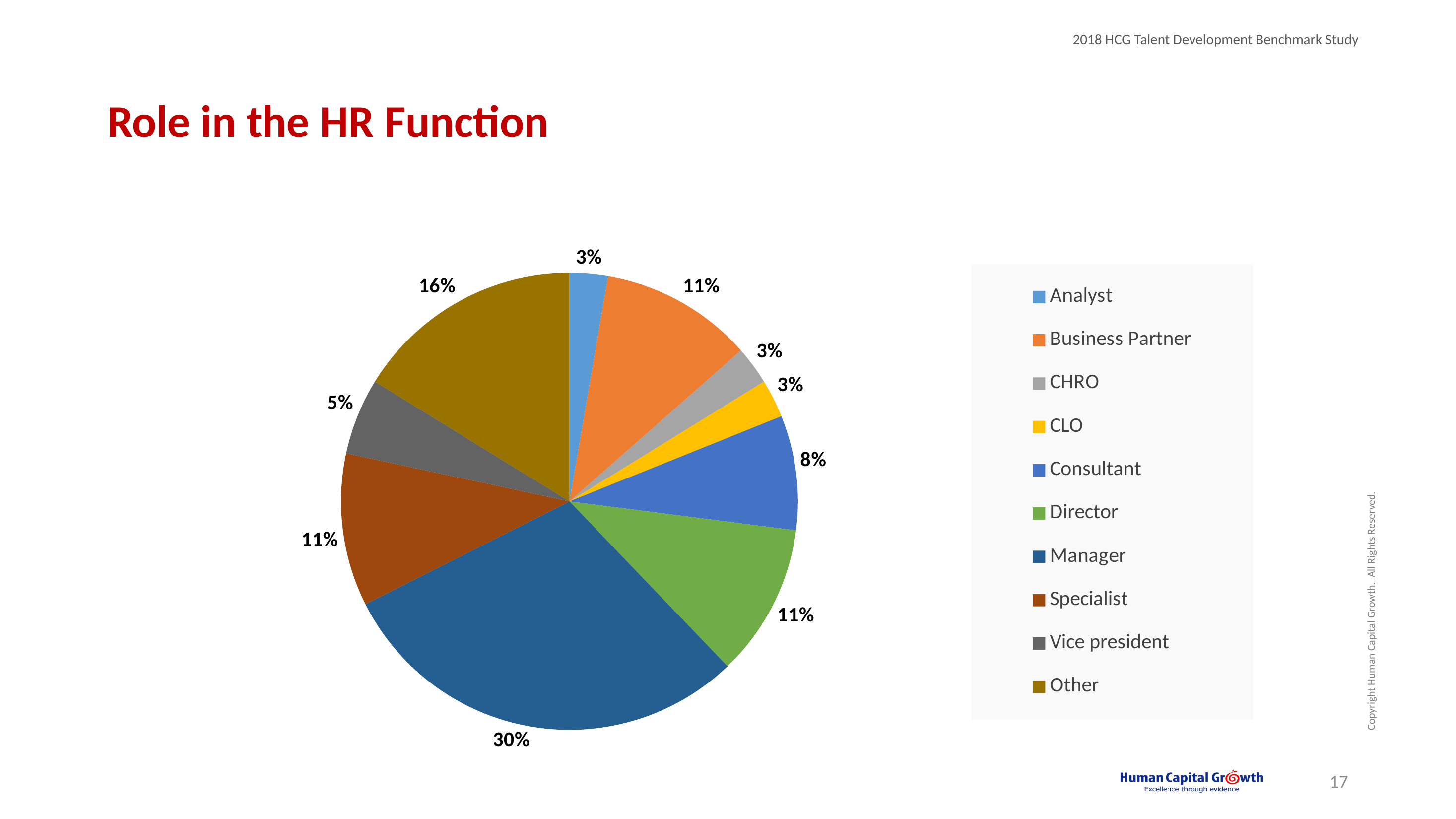
How many categories does the legend list? 10 What is the title of the slide containing the chart? Role in the HR Function What is the difference in percentage points between Business Partner and Analyst? 8 What percentage is shown for Vice president? 5% Which is larger, the share for Consultant or the share for Vice president? Consultant What share of the pie does Manager represent? 30% What percentage is shown for Other? 16% Which role has the largest share of the pie? Manager What type of chart is shown on the slide? Pie chart What is the difference in percentage points between Manager and Other? 14 Which legend entry is shown in yellow? CLO What percentage is shown for Consultant? 8%